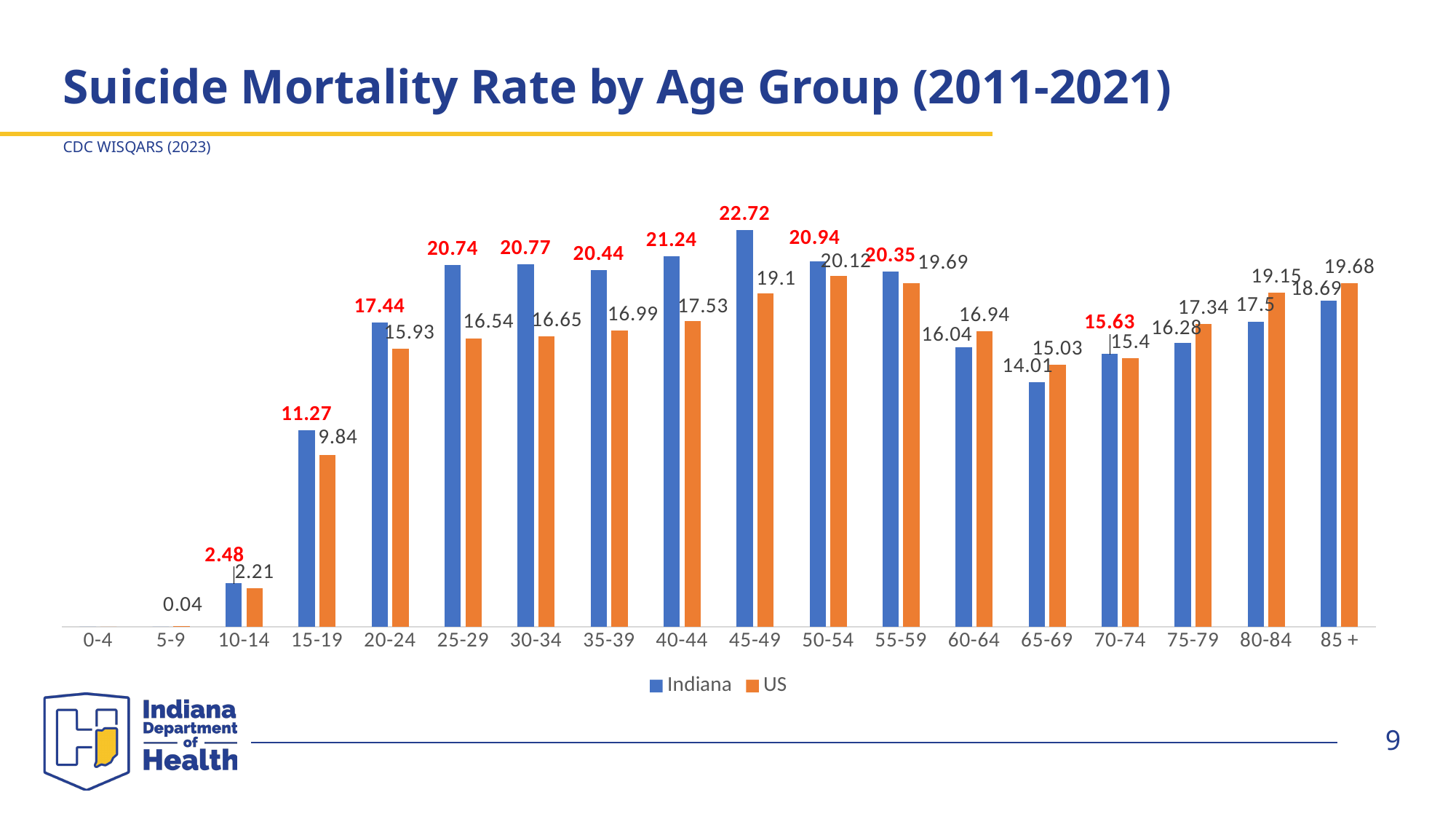
Which age group has the highest US suicide mortality rate? 50-54 For the 80-84 age group, which is larger, the Indiana rate or the US rate? US What is the difference between the Indiana and US rates for the 15-19 age group? 1.43 What is the Indiana suicide mortality rate for the 45-49 age group? 22.72 How many series does the legend list? 2 Which age group has the highest Indiana suicide mortality rate? 45-49 What is the US value for the 85 + age group? 19.68 What is the Indiana value for the 65-69 age group? 14.01 What is the difference between the Indiana and US rates for the 45-49 age group? 3.62 How many age groups are shown on the x axis? 18 What is the US suicide mortality rate for the 15-19 age group? 9.84 What kind of chart is shown on the slide? Bar chart